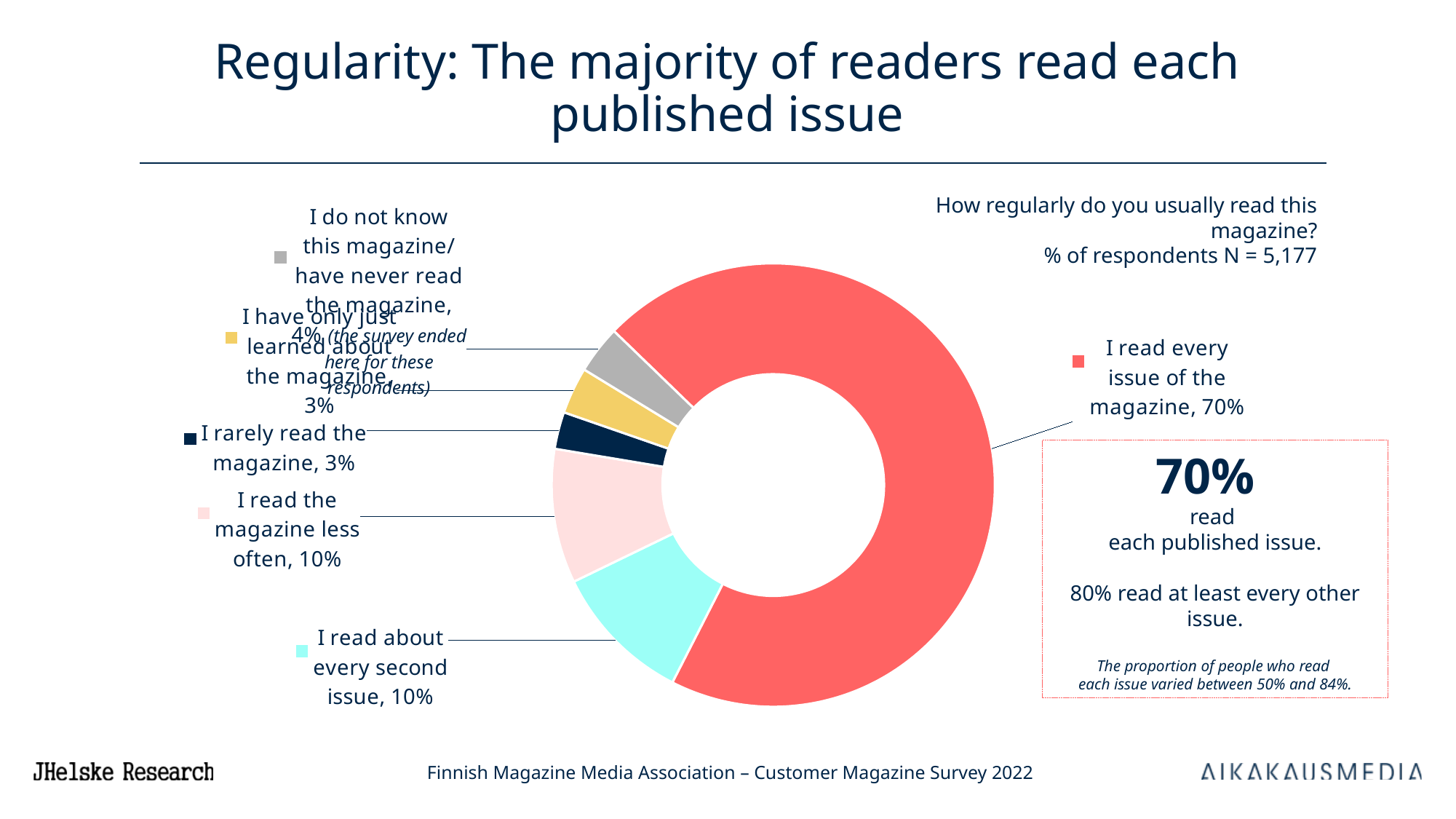
What percentage of respondents say they rarely read the magazine? 3% What colour is the slice for 'I read every issue of the magazine'? red What percentage of respondents have only just learned about the magazine? 3% What percentage of respondents do not know the magazine or have never read it? 4% How many respondents (N) does the chart say answered the question? 5,177 What percentage of respondents say they read every issue of the magazine? 70% Which response category has the largest share of respondents? I read every issue of the magazine What kind of chart is shown on the slide? doughnut chart What percentage of respondents read about every second issue? 10% How many response categories are shown in the chart? 6 Which is larger: the share who do not know the magazine or the share who rarely read the magazine? I do not know this magazine/have never read the magazine (4%) What is the difference in percentage points between those who read every issue and those who read the magazine less often? 60 percentage points